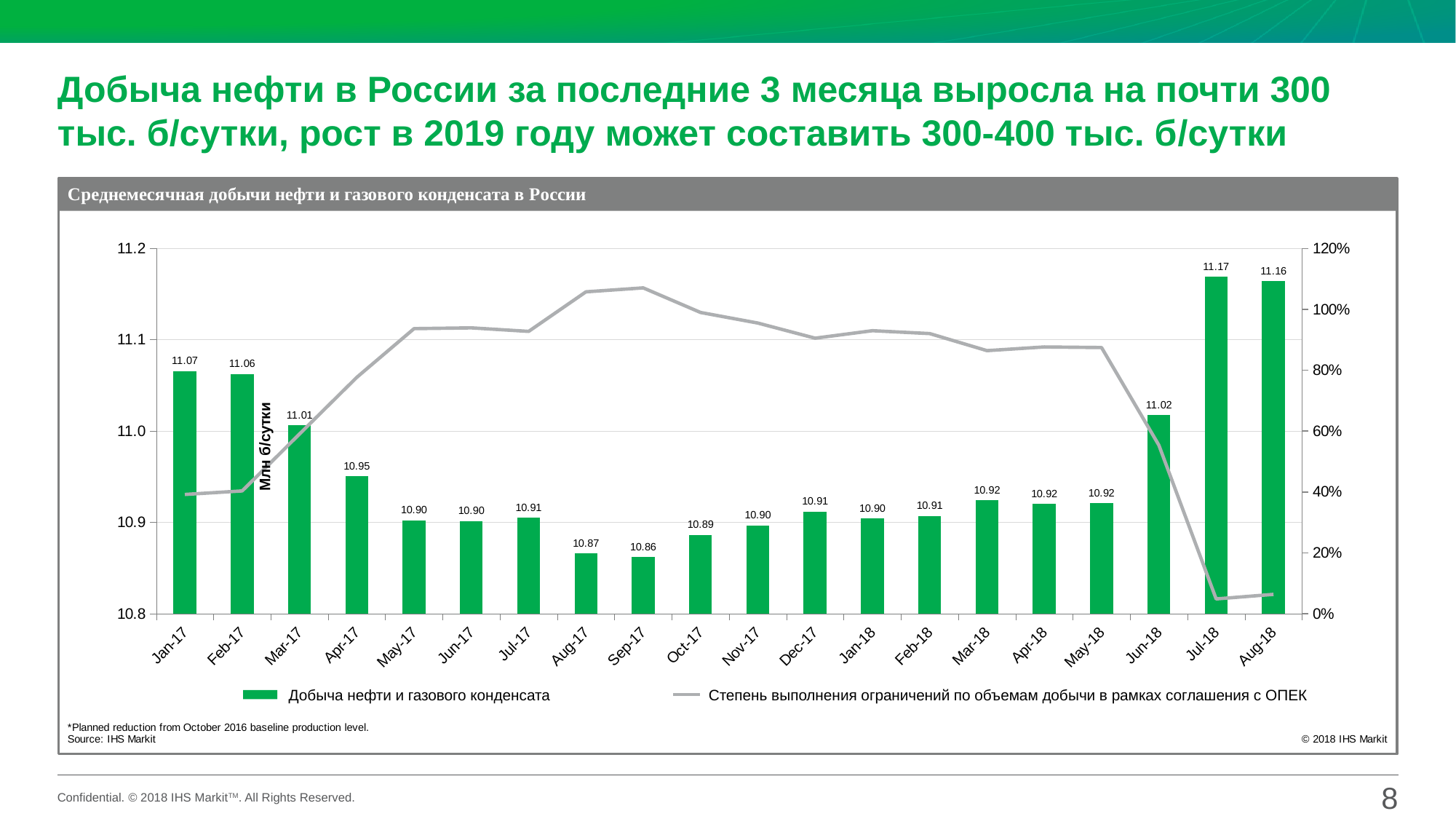
Which is larger, the production value for Jan-17 or for Aug-18? Aug-18 Is the OPEC compliance line value for Jul-18 greater or less than 20%? less How many series does the legend list? 2 How many months are shown on the x axis? 20 What is the production value shown for Apr-17? 10.95 Is the OPEC compliance line value for Aug-17 greater or less than 100%? greater What is the oil and gas condensate production value for Jul-18? 11.17 Which month has the highest production bar? Jul-18 Which month has the lowest production bar? Sep-17 What is the production value shown for Sep-17? 10.86 What is the title of the chart? Среднемесячная добычи нефти и газового конденсата в России What is the difference between the production values for Jul-18 and Sep-17? 0.31